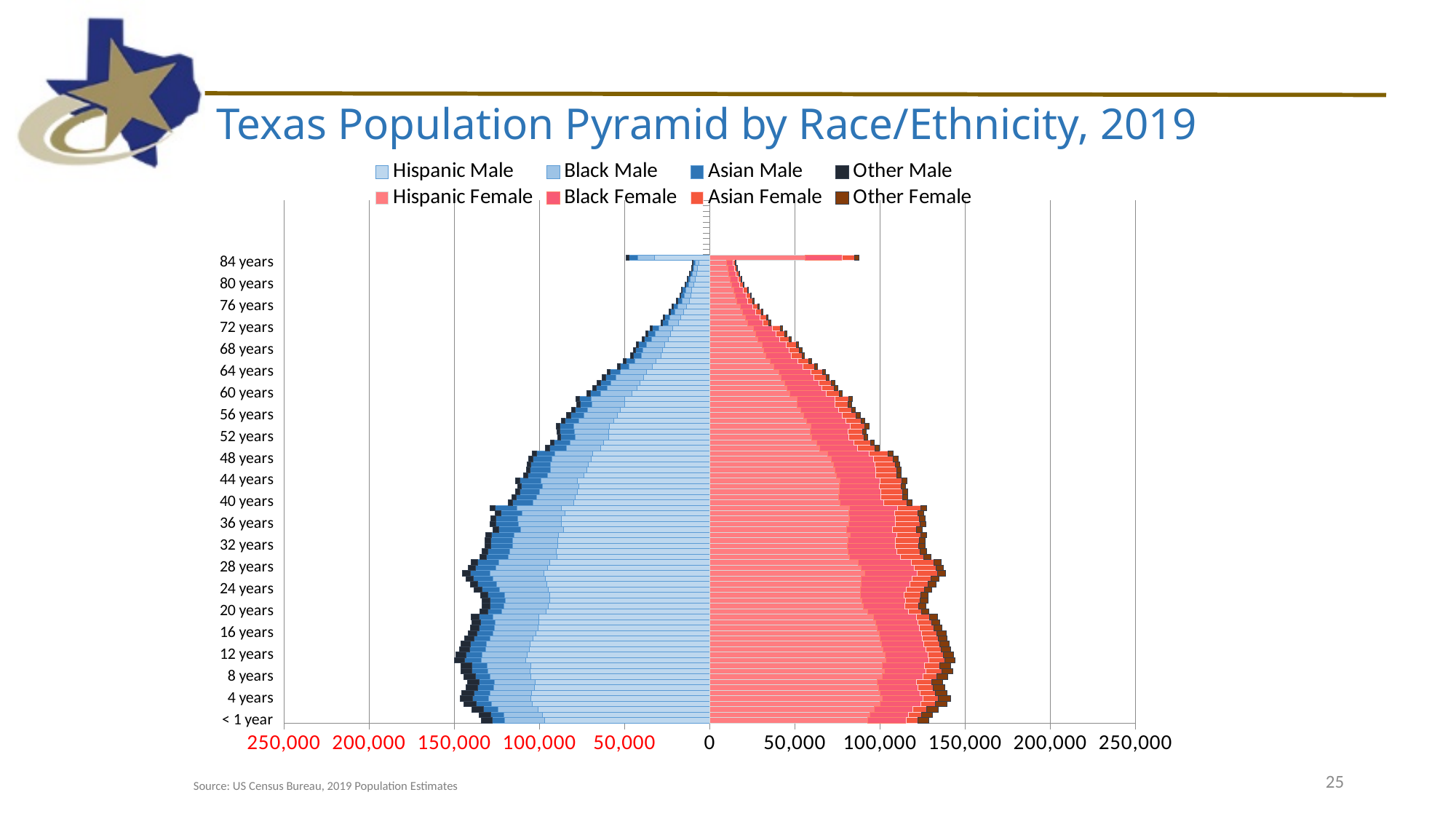
Is the total male bar for 72 years greater or less than 50,000? less Is the total female bar for 12 years greater or less than 100,000? greater Moving from the youngest ages at the bottom to the oldest ages at the top, do the bars generally get longer or shorter? shorter What is the title of the chart? Texas Population Pyramid by Race/Ethnicity, 2019 What kind of chart is shown on the slide? Bar chart (population pyramid) At 84 years, which total bar is longer, the male side or the female side? Female Is the total female bar for 76 years greater or less than 50,000? less Which legend entry is shown with the darkest blue colour? Other Male On the male side, which total bar is longer, 28 years or 60 years? 28 years How many series does the legend list? 8